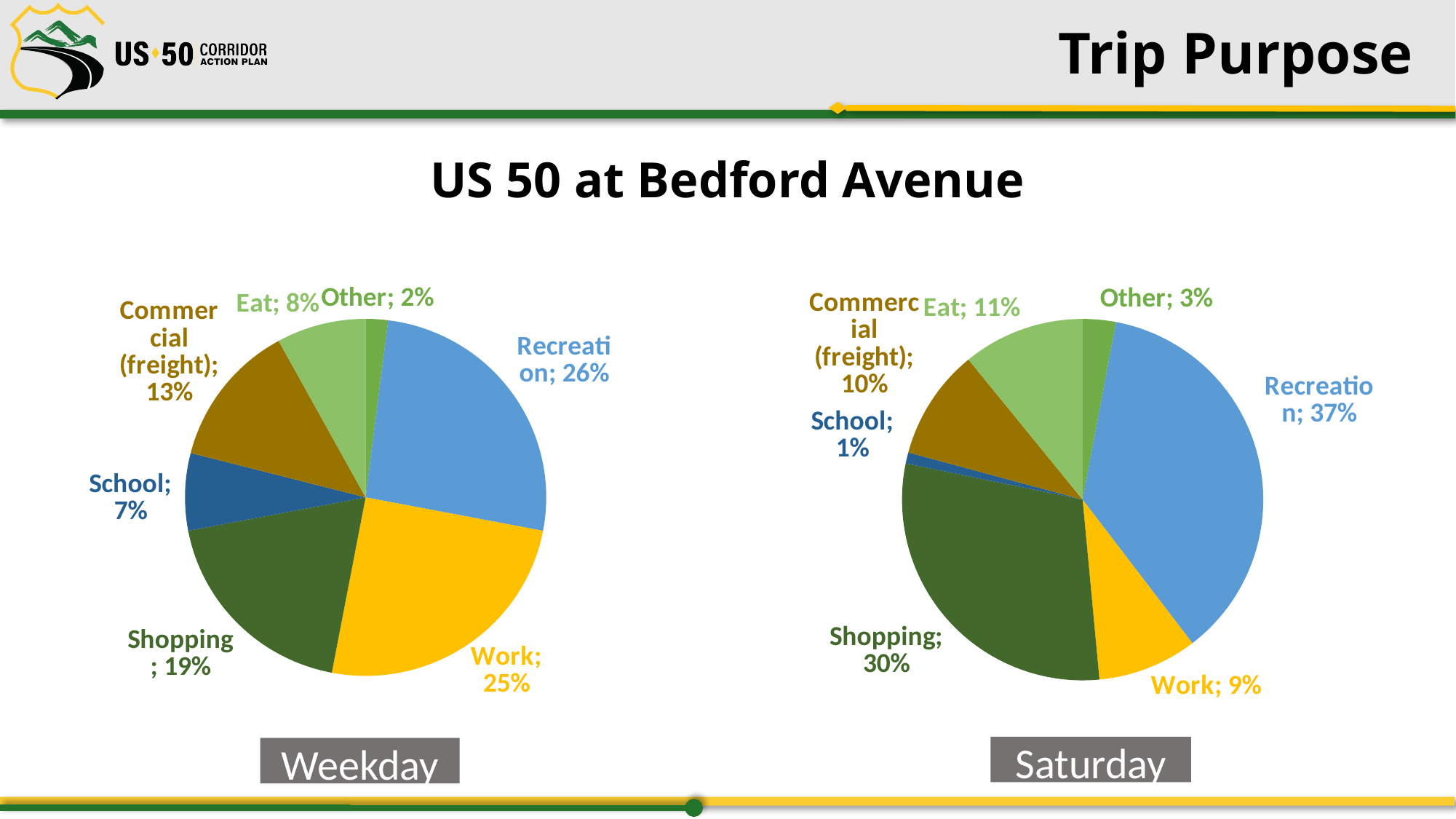
In the Saturday pie chart, what is the value for Commercial (freight)? 10% What type of chart is used for the Weekday data? Pie chart In the Weekday pie chart, which is larger, the share for Shopping or the share for Commercial (freight)? Shopping In the Saturday pie chart, what is the difference between the Recreation share and the Work share? 28% In the Weekday pie chart, which trip purpose has the smallest share? Other In the Weekday pie chart, what share of trips is for Recreation? 26% What is the difference between the Work share on Weekday and the Work share on Saturday? 16% How many categories does the Saturday pie chart show? 7 In the Saturday pie chart, which trip purpose has the smallest share? School In the Saturday pie chart, what share of trips is for Shopping? 30% In the Weekday pie chart, which trip purpose has the largest share? Recreation What is the title shown above the two pie charts? US 50 at Bedford Avenue